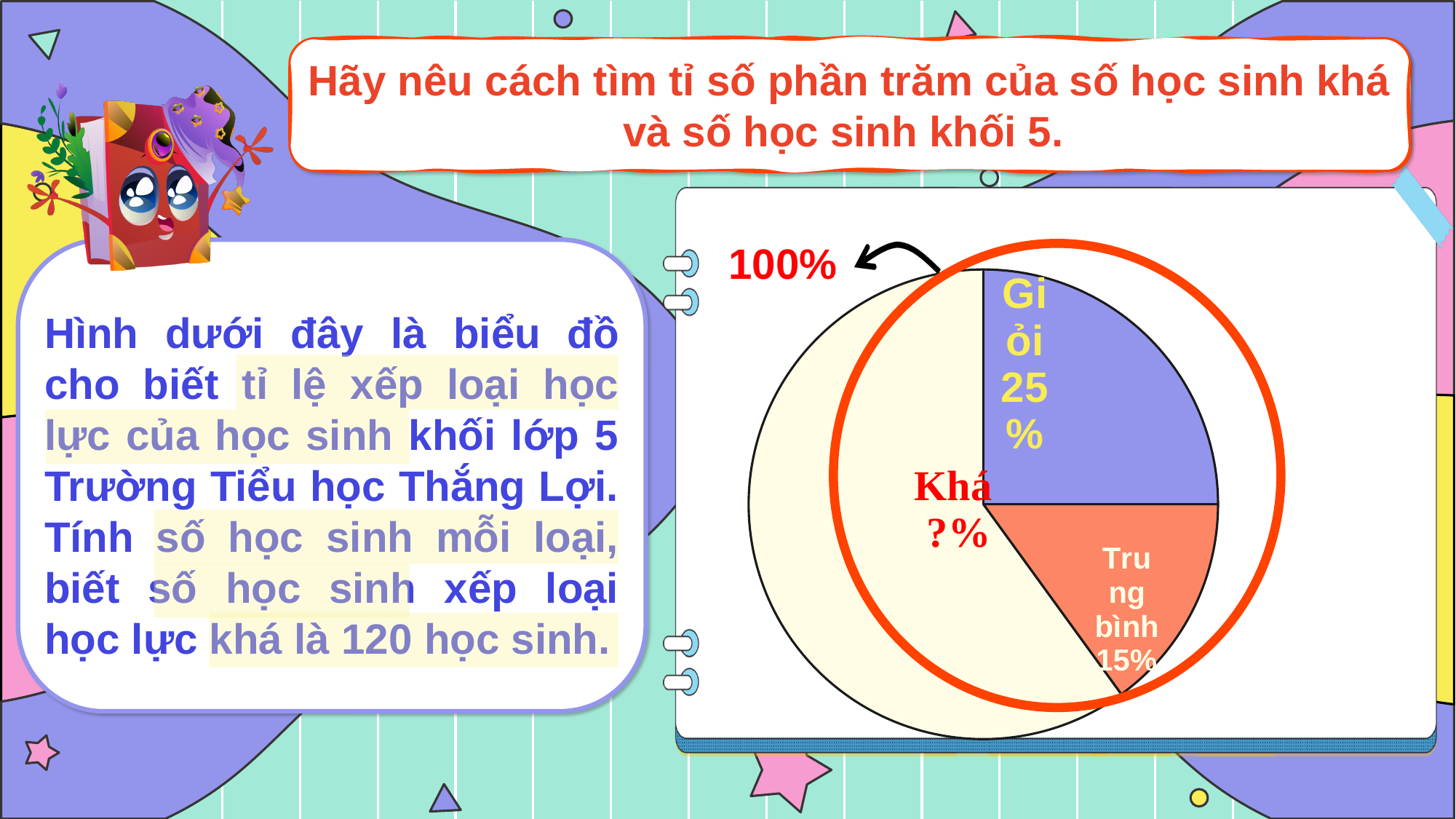
What kind of chart is shown on the slide? pie chart What percentage is shown for the Trung bình slice? 15% Which slice of the pie chart is the smallest? Trung bình Given the whole pie is 100%, what share does the Khá slice represent? 60% Which slice of the pie chart is the largest? Khá What label is printed in place of the percentage for the Khá slice? ?% Is the Khá slice greater or less than 50% of the pie? greater What percentage is shown for the Giỏi slice? 25% What is the difference between the Giỏi and Trung bình percentages? 10% Which slice is larger, Giỏi or Trung bình? Giỏi What colour is the Trung bình slice? orange How many slices does the pie chart have? 3